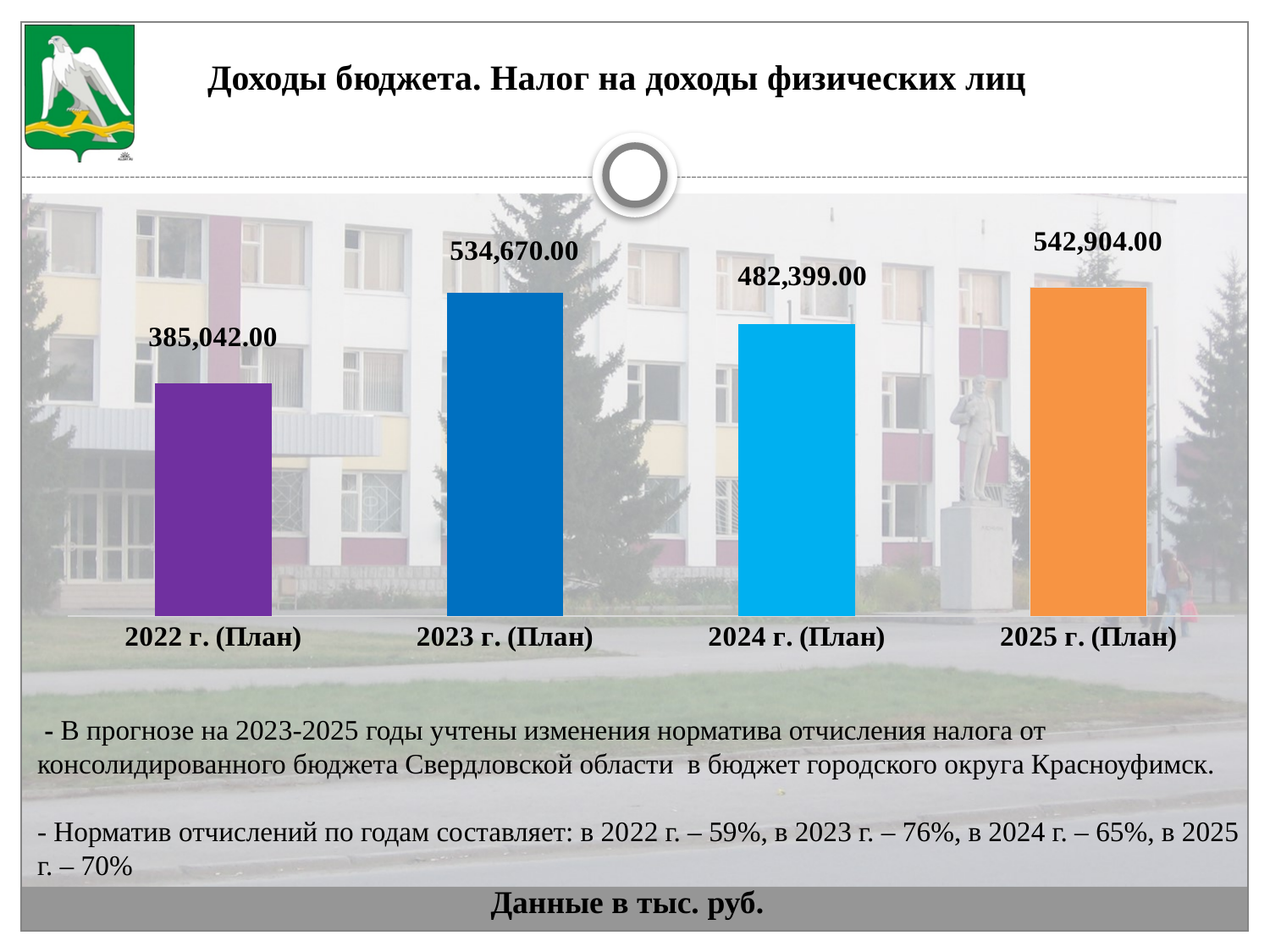
Which year has the highest value? 2025 г. (План) Does the value rise or fall from 2023 г. (План) to 2024 г. (План)? Fall How many bars are shown in the chart? 4 What is the difference between the values for 2025 г. (План) and 2024 г. (План)? 60,505.00 What is the value for 2024 г. (План)? 482,399.00 What is the difference between the values for 2023 г. (План) and 2022 г. (План)? 149,628.00 What is the value for 2025 г. (План)? 542,904.00 What is the value for 2022 г. (План)? 385,042.00 What is the value for 2023 г. (План)? 534,670.00 Which is larger, the value for 2023 г. (План) or 2024 г. (План)? 2023 г. (План) Which year has the lowest value? 2022 г. (План) What kind of chart is shown on the slide? Bar chart